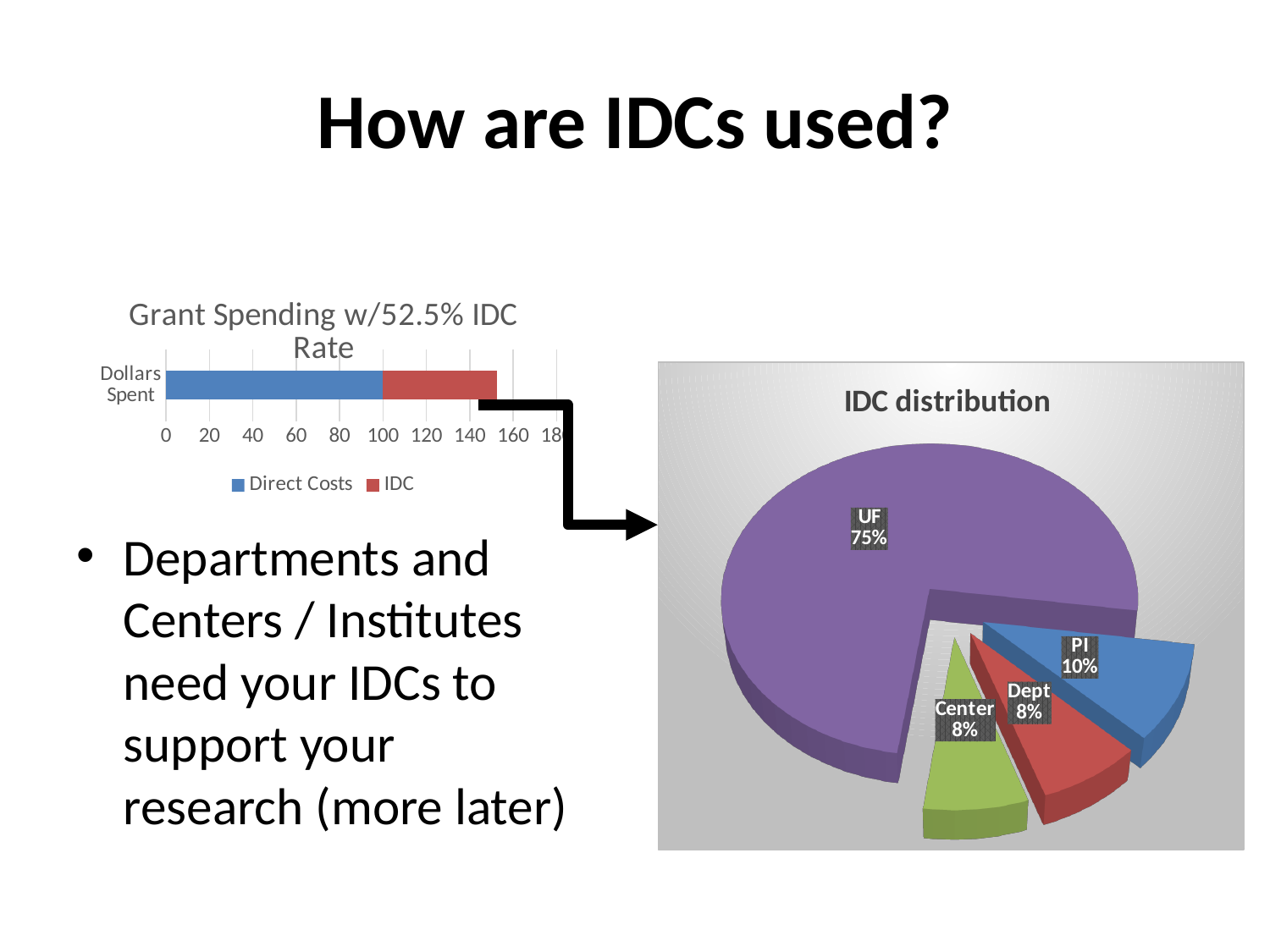
In the 'IDC distribution' chart, which is larger, the PI share or the Dept share? PI In the 'IDC distribution' chart, what share goes to PI? 10% What kind of chart is the 'Grant Spending w/52.5% IDC Rate' chart? bar chart In the 'IDC distribution' chart, how many percentage points larger is the UF share than the PI share? 65% How many series does the legend of the 'Grant Spending w/52.5% IDC Rate' chart list? 2 In the 'IDC distribution' chart, what share goes to UF? 75% In the 'IDC distribution' chart, how many slices does the pie have? 4 In the 'IDC distribution' chart, what share goes to Dept? 8% In the 'IDC distribution' chart, which slice is the largest? UF What kind of chart is the 'IDC distribution' chart? pie chart In the 'Grant Spending w/52.5% IDC Rate' chart, which series is larger, Direct Costs or IDC? Direct Costs In the 'Grant Spending w/52.5% IDC Rate' chart, is the total length of the stacked bar greater or less than 140? greater